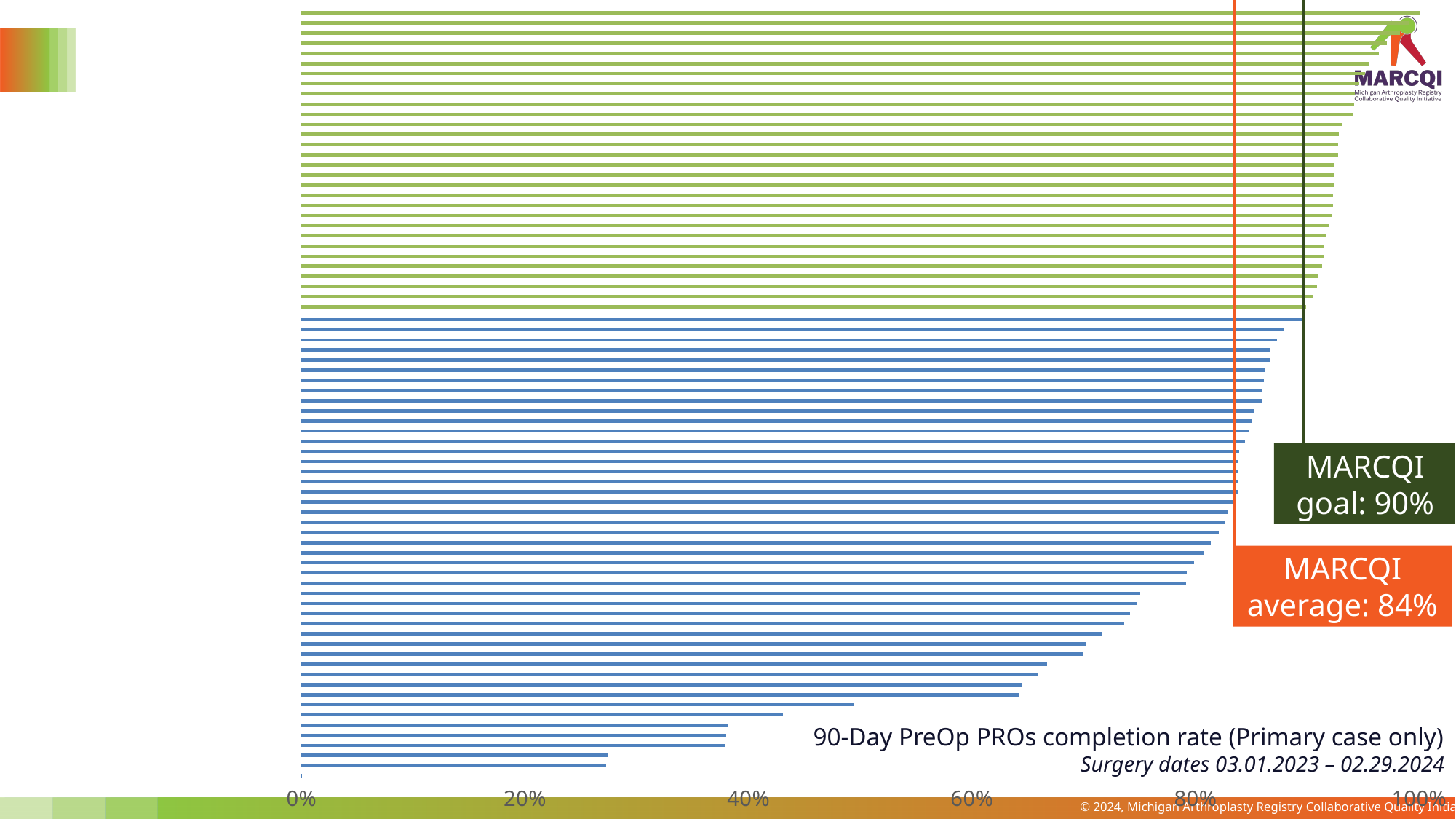
What MARCQI goal value is shown on the chart? 90% What is the maximum value shown on the x axis? 100% Is the value of the longest bar greater or less than 90%? greater Do the bar values increase or decrease from the top of the chart to the bottom? decrease Which is larger, the MARCQI goal or the MARCQI average? MARCQI goal What surgery date range does the chart cover? 03.01.2023 – 02.29.2024 What MARCQI average value is shown on the chart? 84% By how many percentage points does the MARCQI goal exceed the MARCQI average? 6 percentage points What is the title of the chart? 90-Day PreOp PROs completion rate (Primary case only) What kind of chart is shown on the slide? Bar chart Is the value of the shortest bar greater or less than 40%? less